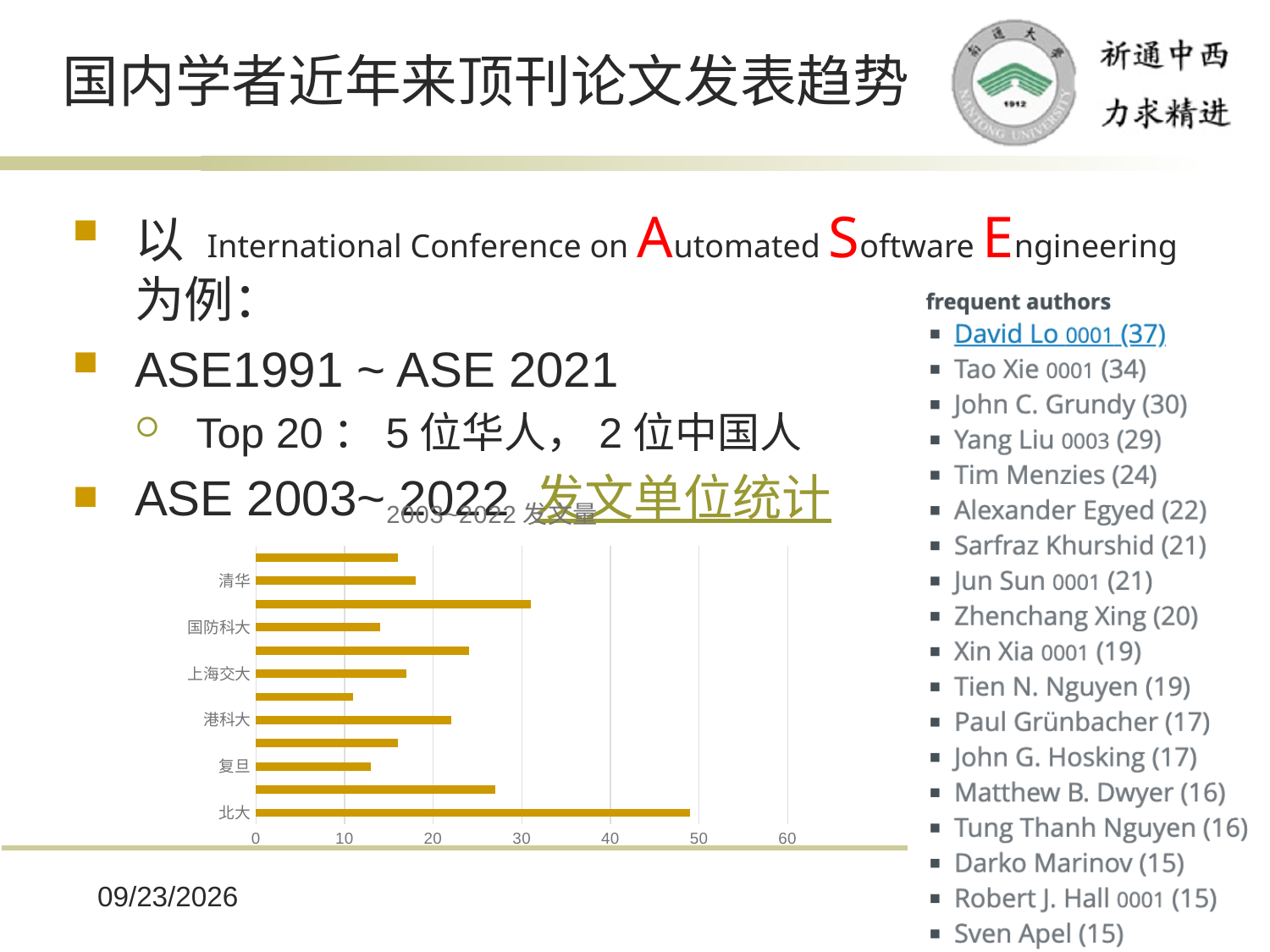
What is the highest tick value shown on the horizontal axis of the chart? 60 Is the value for 港科大 greater or less than 20? greater Which labeled institution has the highest value in the bar chart? 北大 How many bars are plotted in the chart? 12 What kind of chart is shown on the slide? bar chart Is the value for 清华 greater or less than 20? less Is the value for 国防科大 greater or less than 20? less Which has a larger value, 港科大 or 复旦? 港科大 Which has a larger value, 北大 or 清华? 北大